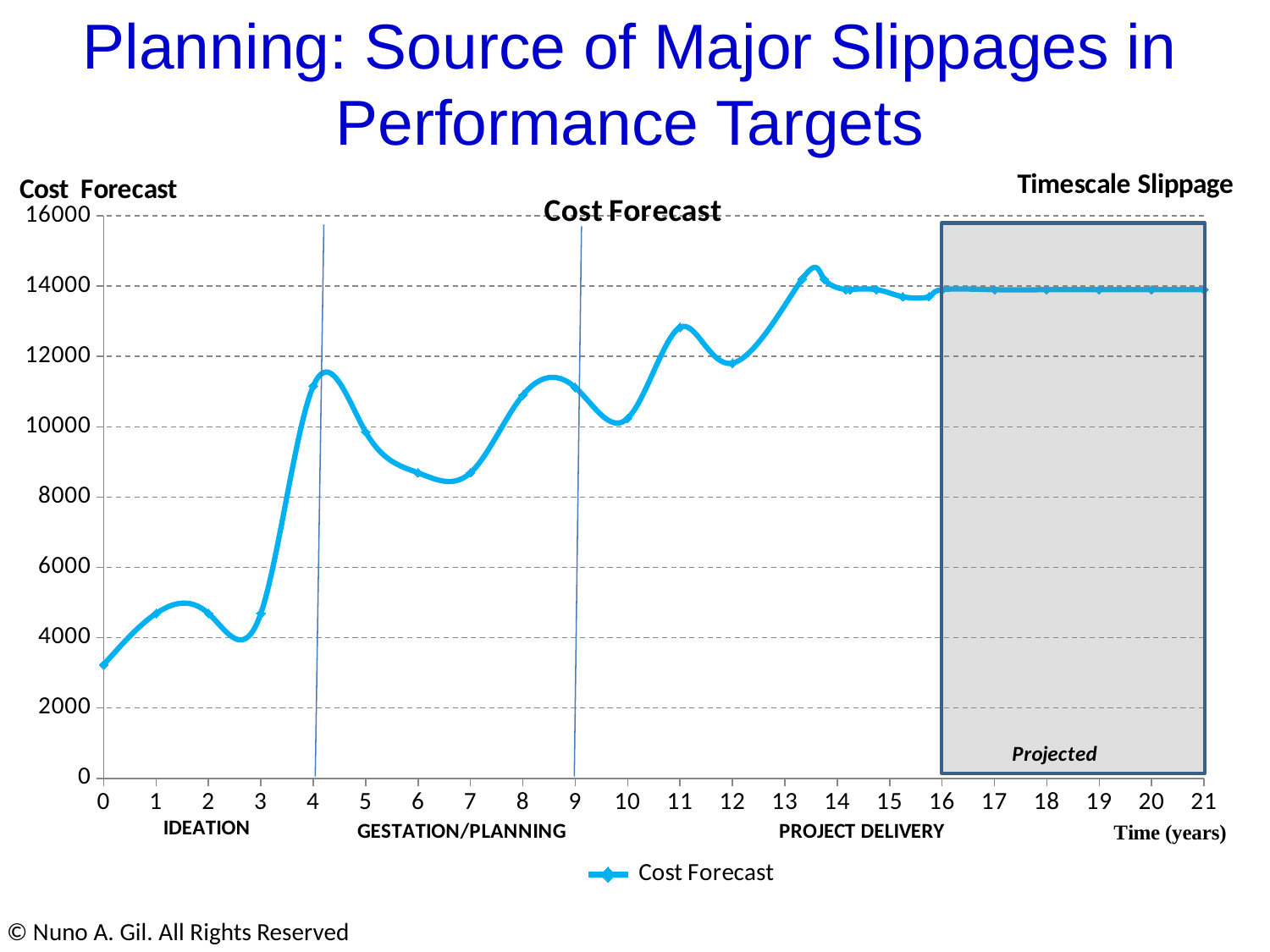
At which year is the cost forecast lowest? 0 Which is larger, the cost forecast at year 6 or at year 8? year 8 How many series does the legend list? 1 Which is larger, the cost forecast at year 1 or at year 4? year 4 Is the cost forecast at year 11 greater or less than 12000? greater What is the label of the x axis? Time (years) What kind of chart is shown on the slide? line chart What is the name of the series shown in the legend? Cost Forecast Overall, does the cost forecast rise or fall from year 0 to year 21? rise Is the cost forecast at year 0 greater or less than 4000? less Is the cost forecast at year 4 greater or less than 10000? greater